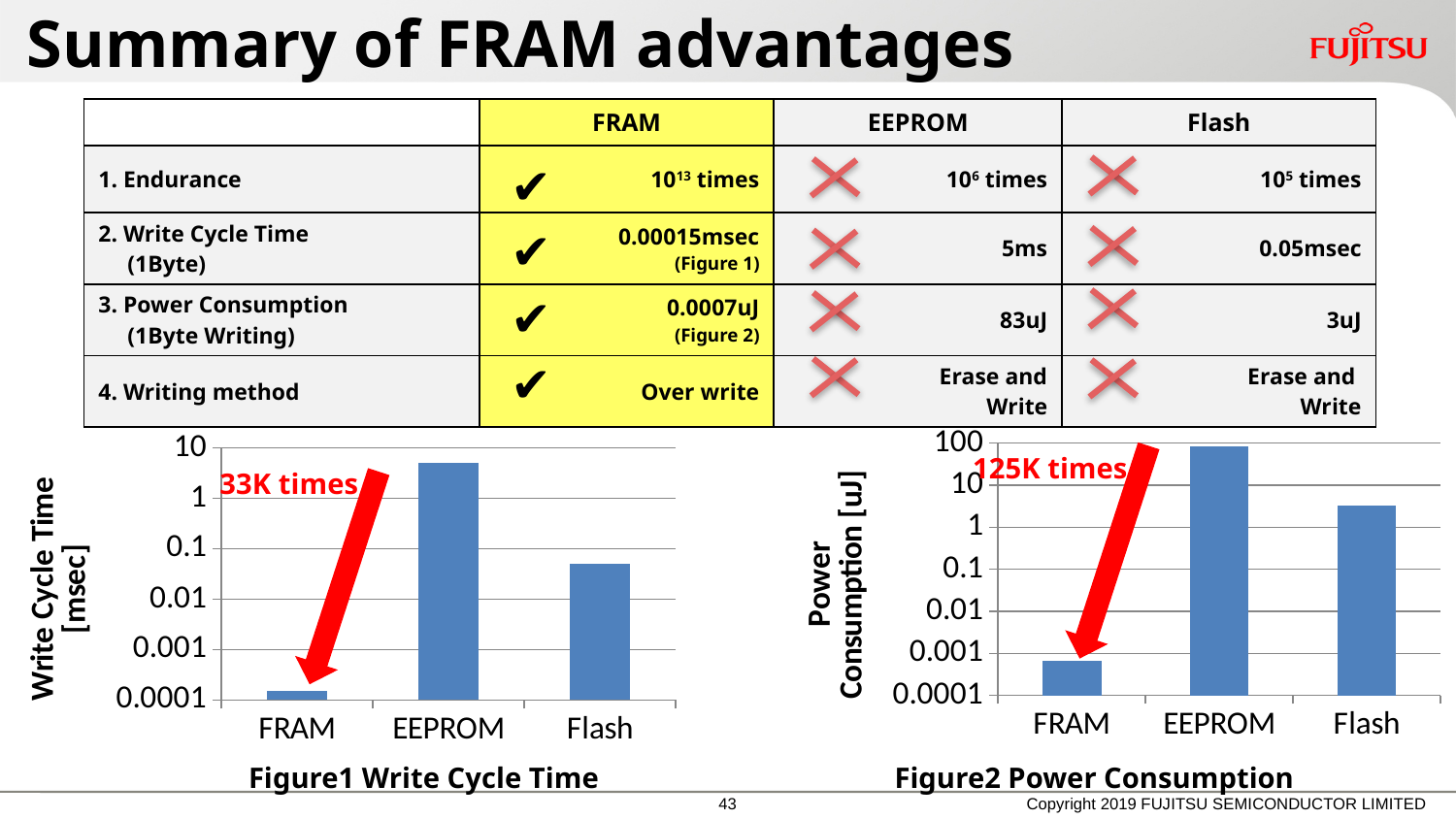
In Figure2 Power Consumption, which is larger, the value for EEPROM or the value for Flash? EEPROM In Figure2 Power Consumption, which category has the lowest power consumption? FRAM In Figure2 Power Consumption, which category has the highest power consumption? EEPROM In Figure1 Write Cycle Time, how many categories are shown on the x axis? 3 In Figure2 Power Consumption, is the value for Flash greater or less than 1? greater In Figure1 Write Cycle Time, is the value for Flash greater or less than 0.1? less In Figure1 Write Cycle Time, is the value for EEPROM greater or less than 1? greater What is the y-axis label of Figure1 Write Cycle Time? Write Cycle Time [msec] What kind of chart is Figure2 Power Consumption? bar chart In Figure1 Write Cycle Time, which category has the highest write cycle time? EEPROM In Figure1 Write Cycle Time, which category has the lowest write cycle time? FRAM